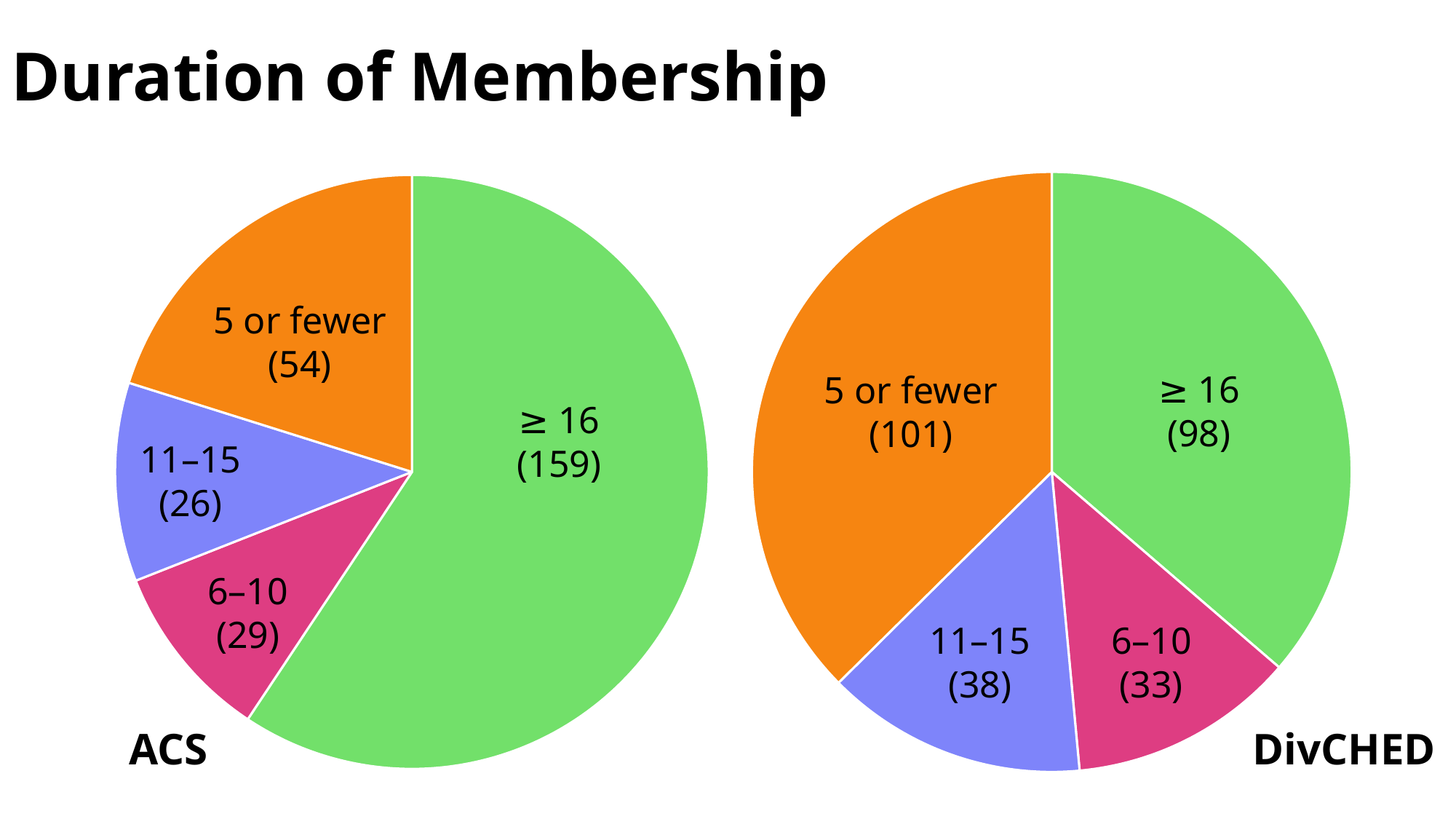
In the ACS pie chart, how many members have a membership duration of 16 years or more? 159 In the ACS pie chart, which category has the smallest value? 11–15 What type of chart is used for the DivCHED data? Pie chart In the ACS pie chart, what is the difference between the ≥ 16 value and the 5 or fewer value? 105 What is the title of the slide? Duration of Membership How many categories does the ACS pie chart have? 4 In the DivCHED pie chart, what is the value for the 11–15 category? 38 In the ACS pie chart, what is the value for the 6–10 category? 29 In the DivCHED pie chart, what is the difference between the 11–15 value and the 6–10 value? 5 In the DivCHED pie chart, which category has the largest value? 5 or fewer In the DivCHED pie chart, which category has the smallest value? 6–10 Which is larger: the 5 or fewer value in the ACS chart or the 5 or fewer value in the DivCHED chart? DivCHED